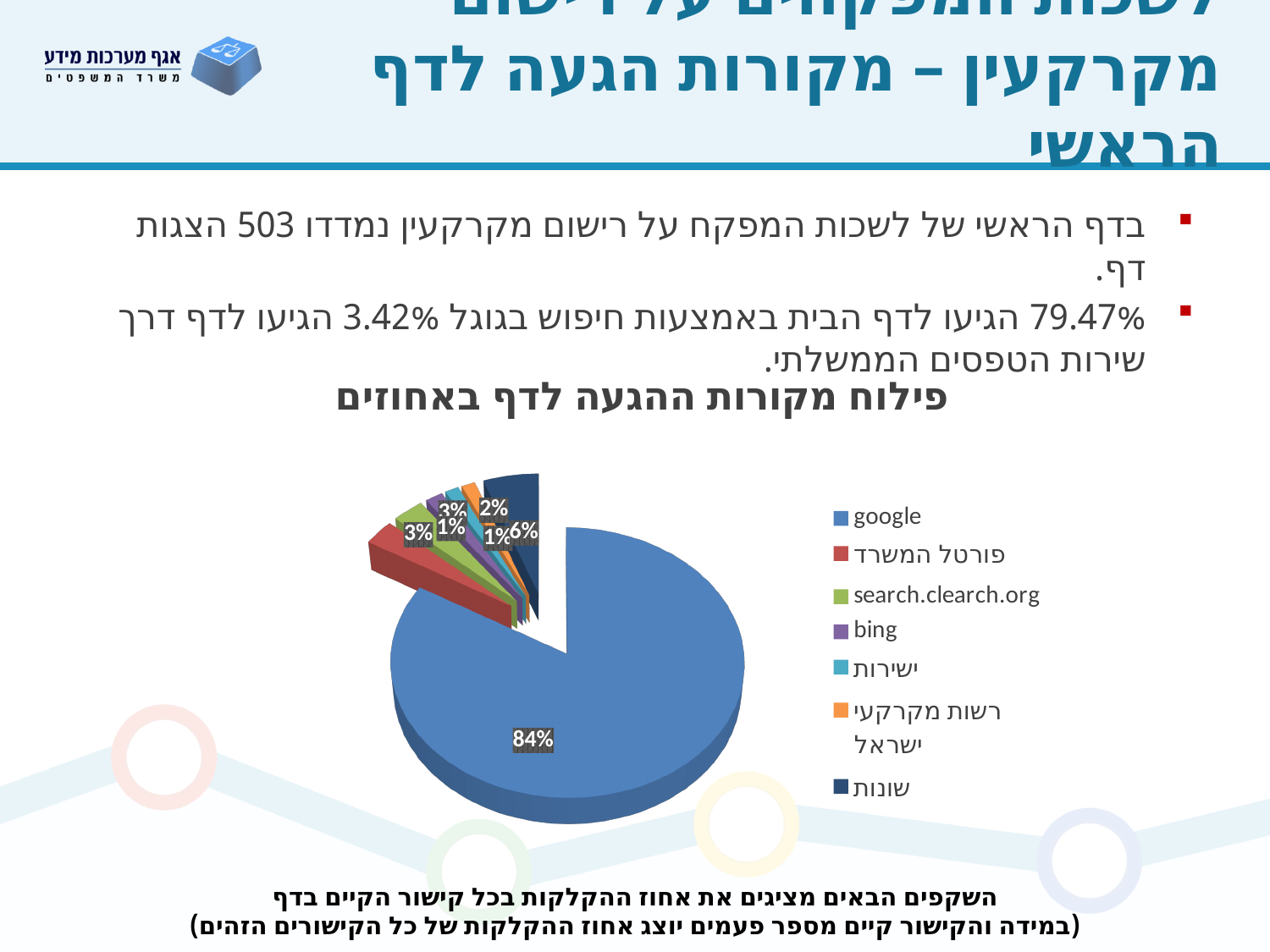
How many entries does the legend of the pie chart list? 7 Which legend entry is shown in blue in the pie chart? google Which slice is larger, google or פורטל המשרד? google What kind of chart is shown on the slide? pie chart What is the title of the pie chart? פילוח מקורות ההגעה לדף באחוזים What share of the pie does google account for? 84% Which slice is larger, google or שונות? google Which source has the largest slice in the pie chart? google What is the data label printed on the largest slice of the pie chart? 84% How many slices does the pie chart have? 7